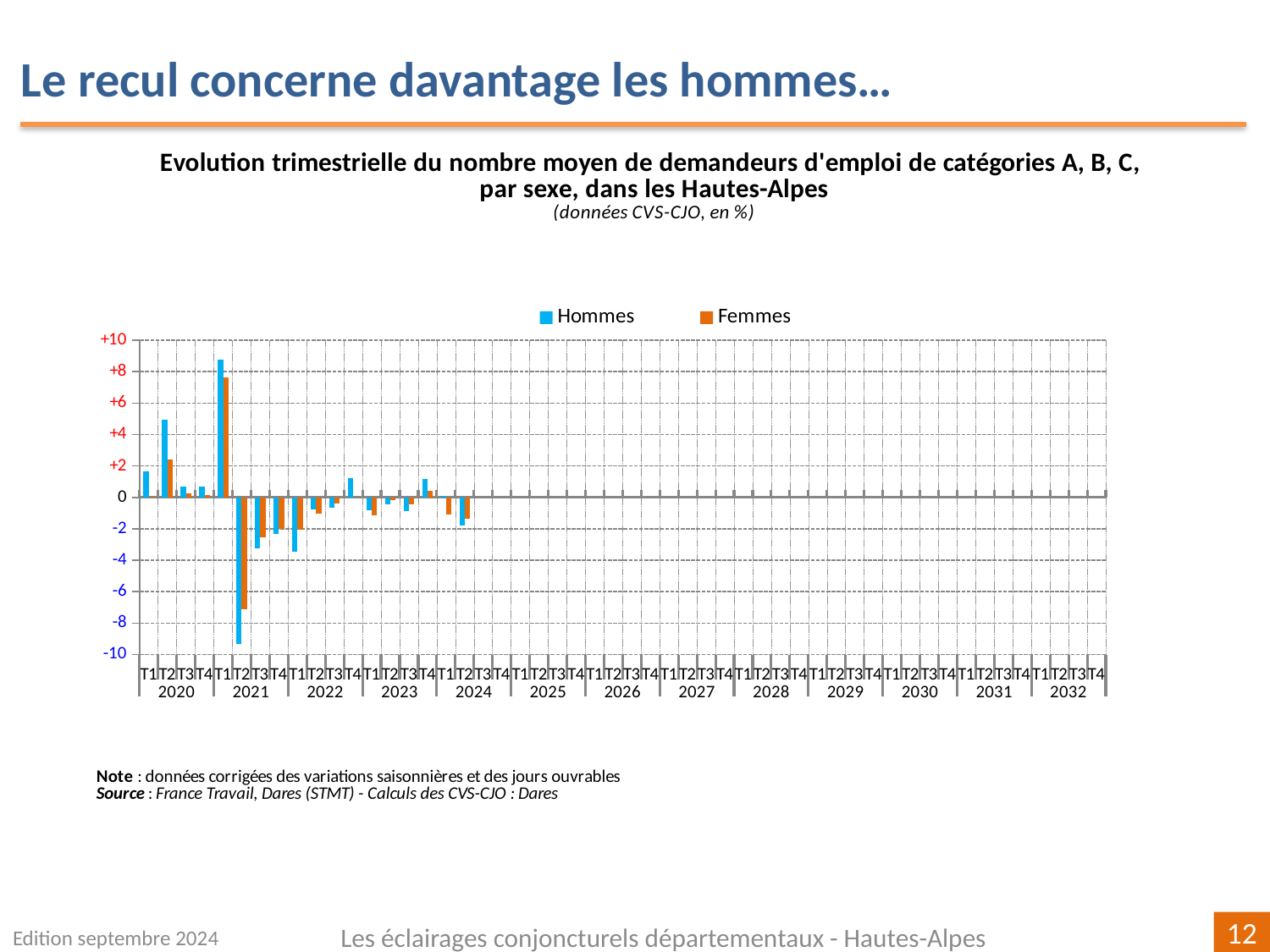
Is the Femmes value for T1 2021 greater or less than +8? less Is the Hommes value for T1 2021 greater or less than +8? greater Which colour represents the Hommes series? blue In T1 2021, which series has the larger value, Hommes or Femmes? Hommes Which quarter shows the lowest value for Hommes? T2 2021 Is the Hommes value for T2 2020 greater or less than +4? greater What kind of chart is shown on the slide? bar chart What are the two series named in the legend? Hommes and Femmes Which quarter shows the highest value for Hommes? T1 2021 How many series does the legend list? 2 How many years are labelled along the x axis? 13